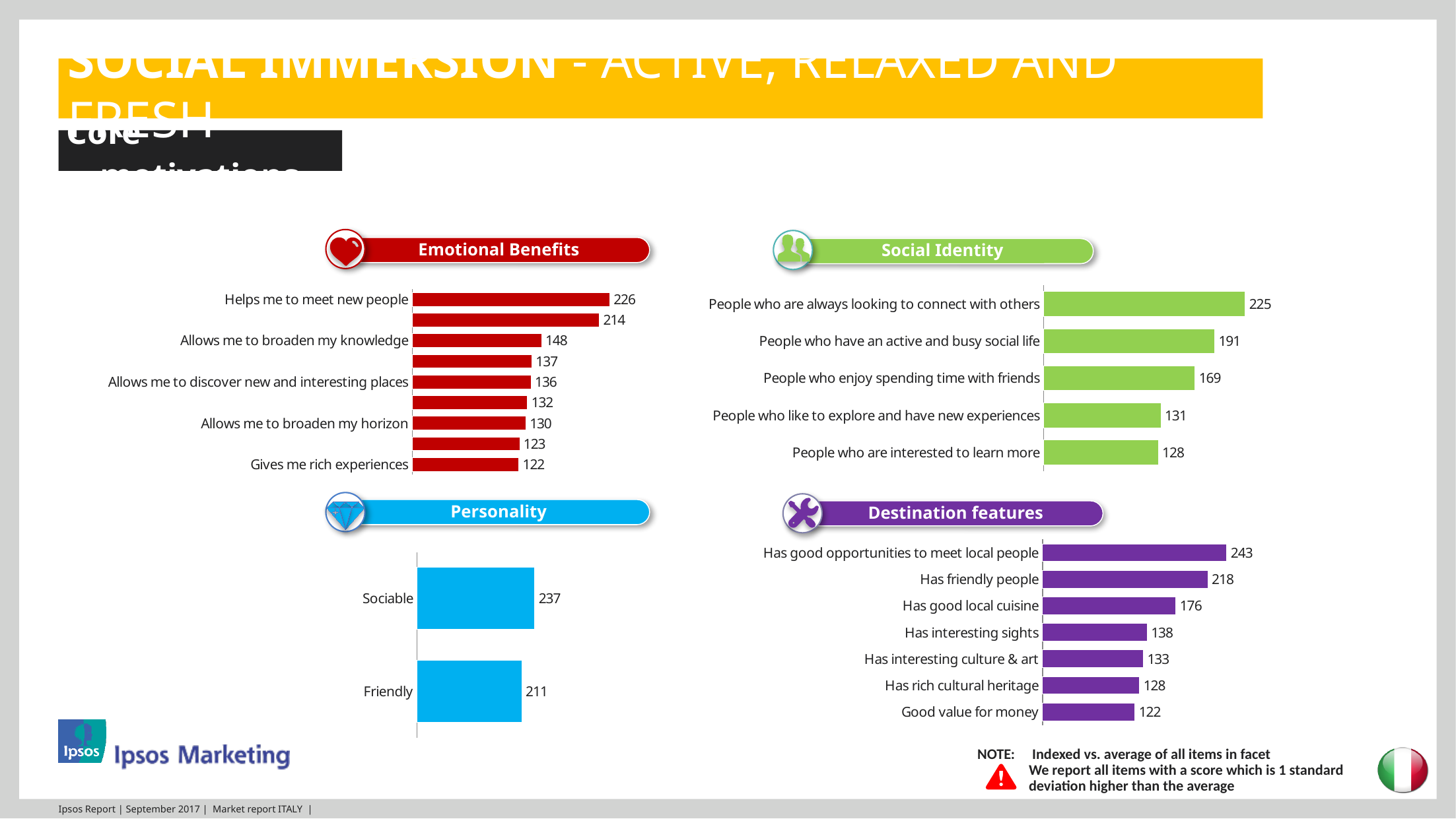
In the Personality chart, what is the value for Friendly? 211 In the Social Identity chart, what is the difference between "People who have an active and busy social life" and "People who are interested to learn more"? 63 In the Destination features chart, how many categories are plotted? 7 In the Social Identity chart, how many categories are plotted? 5 In the Emotional Benefits chart, what is the value for "Helps me to meet new people"? 226 In the Social Identity chart, which category has the highest value? People who are always looking to connect with others In the Destination features chart, what is the value for "Has good local cuisine"? 176 In the Personality chart, which is larger, Sociable or Friendly? Sociable In the Social Identity chart, what is the value for "People who enjoy spending time with friends"? 169 What type of chart is the Destination features chart? Bar chart In the Destination features chart, which category has the lowest value? Good value for money In the Emotional Benefits chart, what is the value for "Gives me rich experiences"? 122